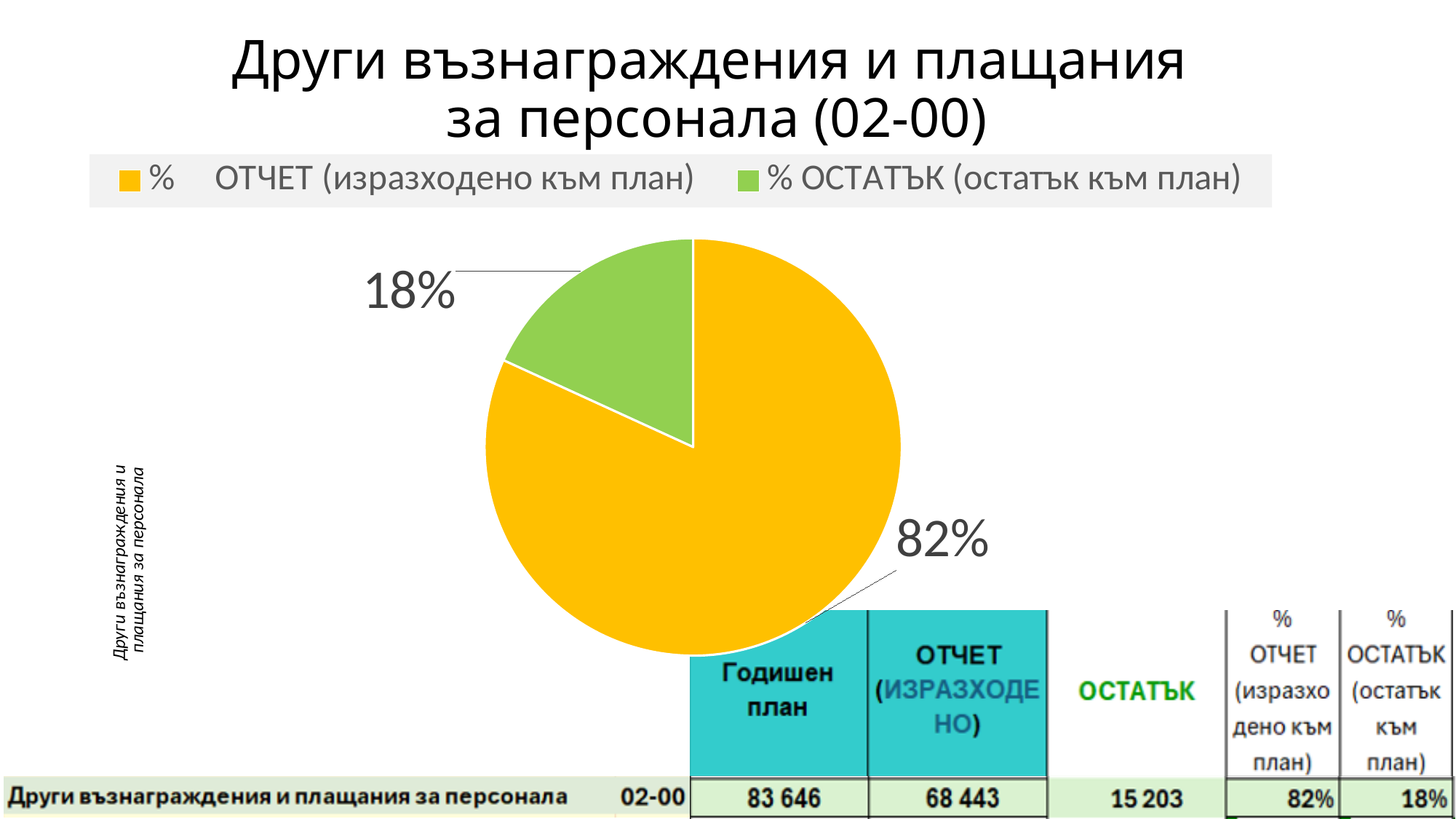
What colour is the "% ОСТАТЪК (остатък към план)" slice? green Is the share of the "% ОСТАТЪК (остатък към план)" slice greater or less than 50%? less Which slice of the pie is the largest? % ОТЧЕТ (изразходено към план) What colour is the "% ОТЧЕТ (изразходено към план)" slice? yellow How many entries does the chart legend list? 2 Which is larger, the "% ОТЧЕТ (изразходено към план)" slice or the "% ОСТАТЪК (остатък към план)" slice? % ОТЧЕТ (изразходено към план) What kind of chart is shown on the slide? pie chart What is the difference in percentage points between the "% ОТЧЕТ" slice and the "% ОСТАТЪК" slice? 64 What share of the pie does the "% ОСТАТЪК (остатък към план)" slice represent? 18% Which slice of the pie is the smallest? % ОСТАТЪК (остатък към план) What share of the pie does the "% ОТЧЕТ (изразходено към план)" slice represent? 82% How many slices does the pie chart have? 2